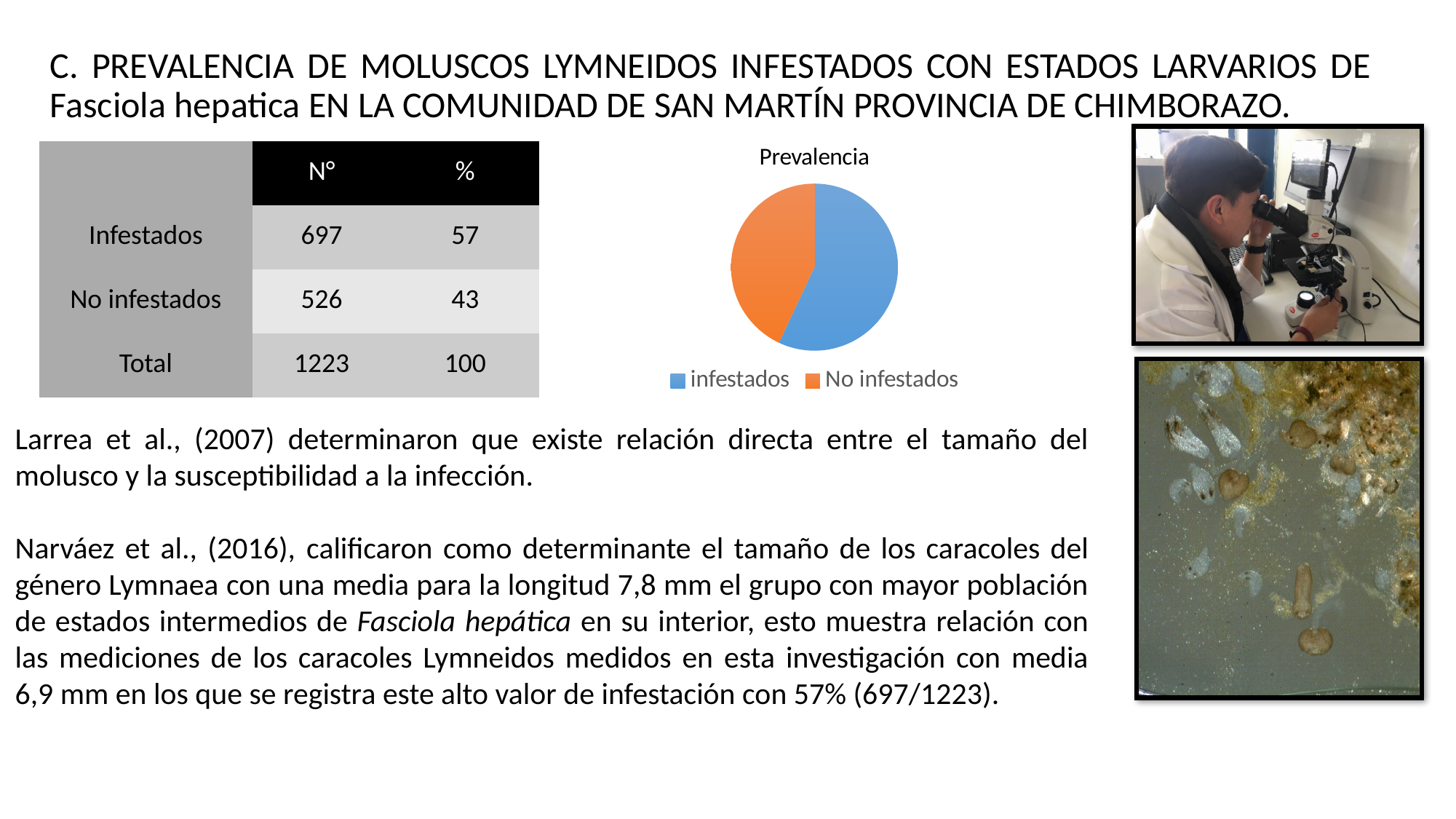
What is the title of the pie chart on the slide? Prevalencia Which category has the smallest slice in the "Prevalencia" pie chart? No infestados How many entries does the legend of the "Prevalencia" pie chart list? 2 How many slices does the "Prevalencia" pie chart have? 2 What kind of chart is shown under the title "Prevalencia"? pie chart In the "Prevalencia" pie chart, which slice is larger, infestados or No infestados? infestados According to the table on the slide, what percentage share does the No infestados slice of the "Prevalencia" pie chart represent? 43% According to the table on the slide, what percentage share does the infestados slice of the "Prevalencia" pie chart represent? 57% Does the infestados slice of the "Prevalencia" pie chart cover more or less than half of the pie? more What colour is the infestados slice in the "Prevalencia" pie chart? blue Which category has the largest slice in the "Prevalencia" pie chart? infestados